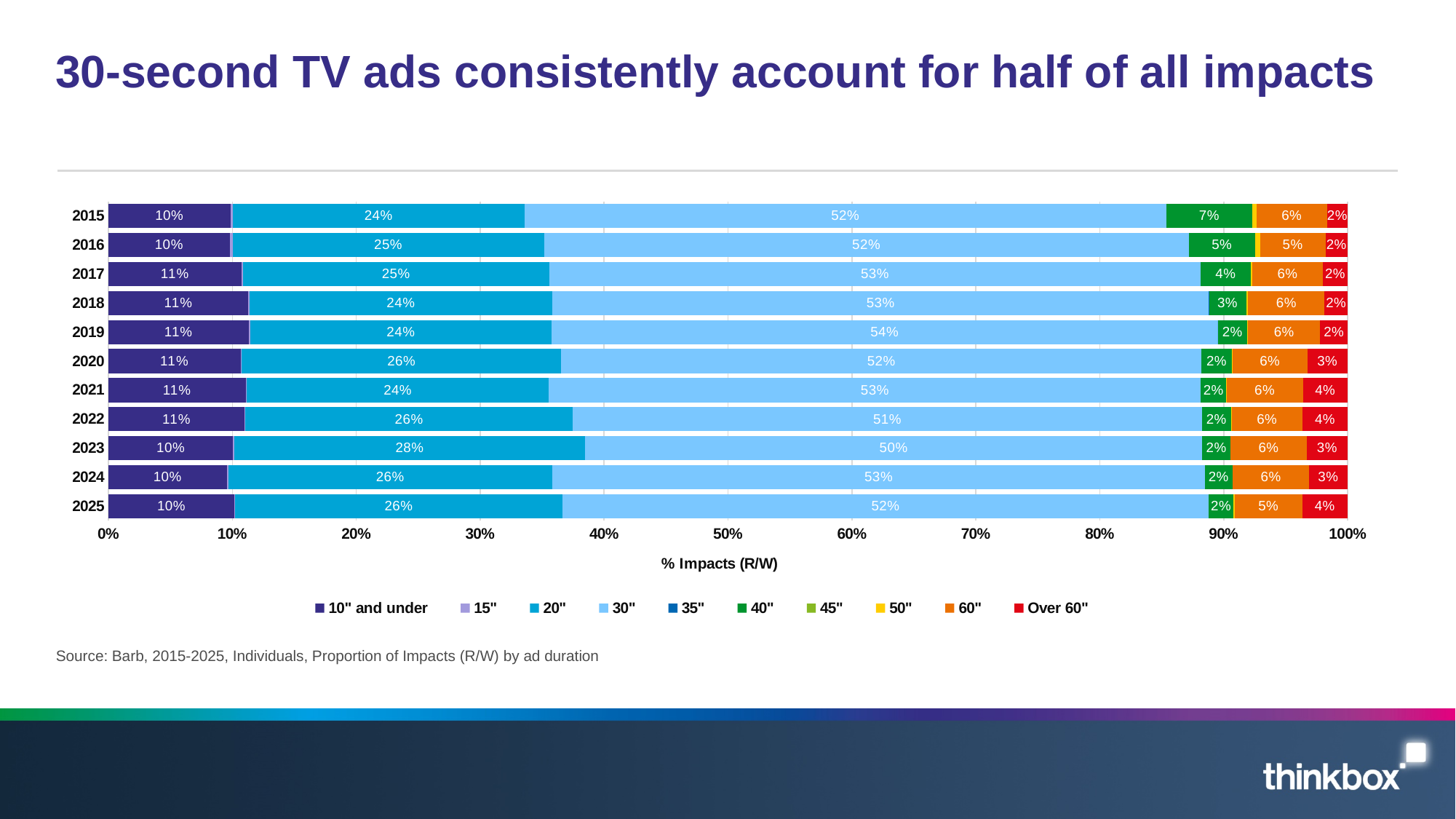
What is the title of the horizontal axis? % Impacts (R/W) How many series does the legend list? 10 In which year was the 30" share of impacts lowest? 2023 What is the value for 20" ads in 2023? 28% In which year was the 30" share of impacts highest? 2019 By how many percentage points did the 20" share in 2023 exceed the 20" share in 2015? 4 percentage points What percentage of impacts did 30" ads account for in 2019? 54% What share of impacts did 40" ads have in 2015? 7% How many years are shown on the chart? 11 What type of chart is shown on the slide? Stacked bar chart What is the value for Over 60" ads in 2021? 4% Which year had the larger 40" share, 2015 or 2016? 2015